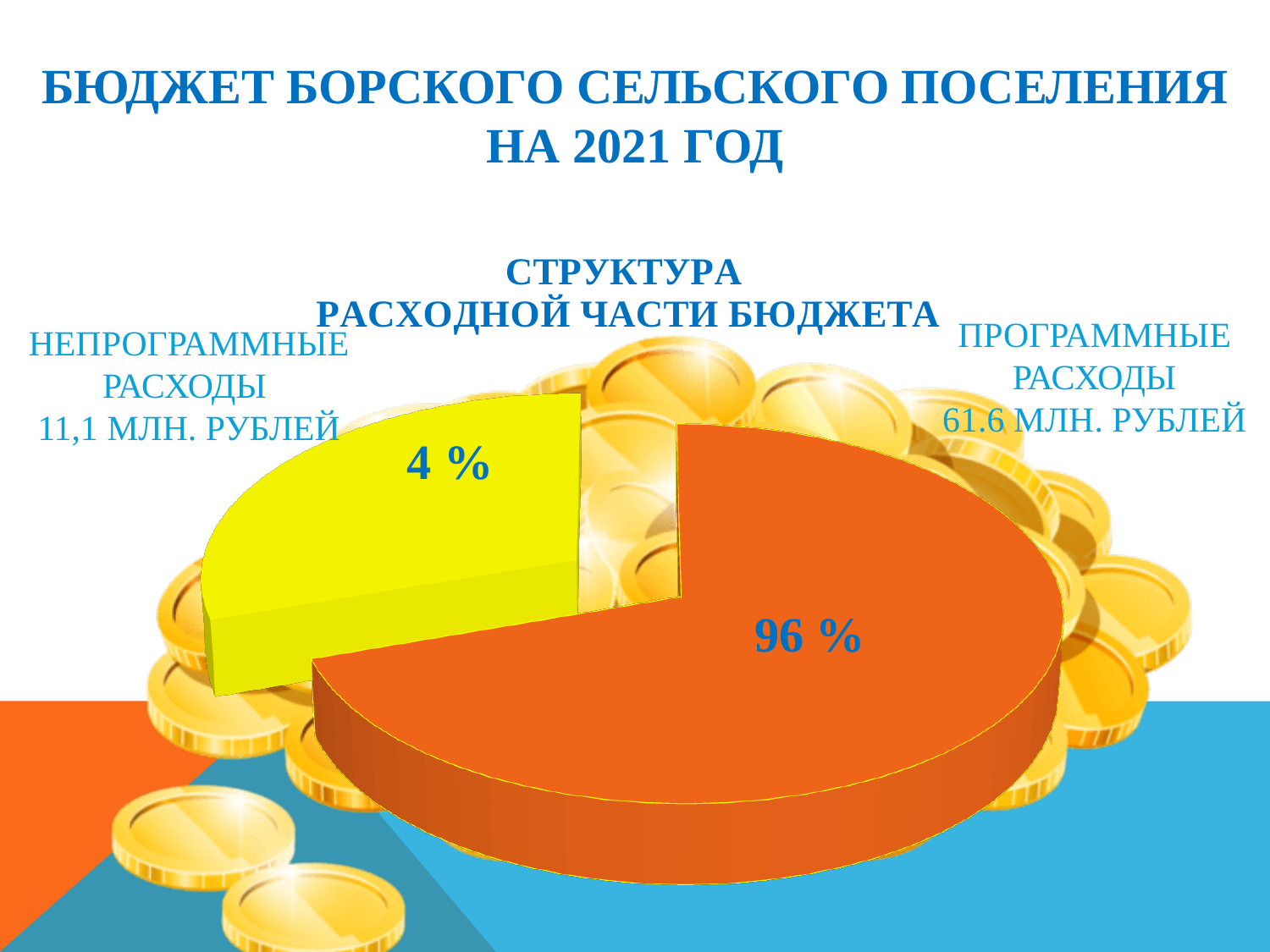
Which is larger, the share for ПРОГРАММНЫЕ РАСХОДЫ or for НЕПРОГРАММНЫЕ РАСХОДЫ? ПРОГРАММНЫЕ РАСХОДЫ What amount in million rubles is shown for ПРОГРАММНЫЕ РАСХОДЫ? 61.6 МЛН. РУБЛЕЙ What share of the pie is labelled for ПРОГРАММНЫЕ РАСХОДЫ? 96 % What colour is the slice representing ПРОГРАММНЫЕ РАСХОДЫ? Orange Which category has the smallest share of the pie? НЕПРОГРАММНЫЕ РАСХОДЫ What kind of chart is shown on the slide? Pie chart What is the difference in percentage points between the ПРОГРАММНЫЕ РАСХОДЫ share and the НЕПРОГРАММНЫЕ РАСХОДЫ share? 92 percentage points What is the title of the chart? СТРУКТУРА РАСХОДНОЙ ЧАСТИ БЮДЖЕТА What amount in million rubles is shown for НЕПРОГРАММНЫЕ РАСХОДЫ? 11,1 МЛН. РУБЛЕЙ How many slices does the pie chart have? 2 What share of the pie is labelled for НЕПРОГРАММНЫЕ РАСХОДЫ? 4 % Which category has the largest share of the pie? ПРОГРАММНЫЕ РАСХОДЫ